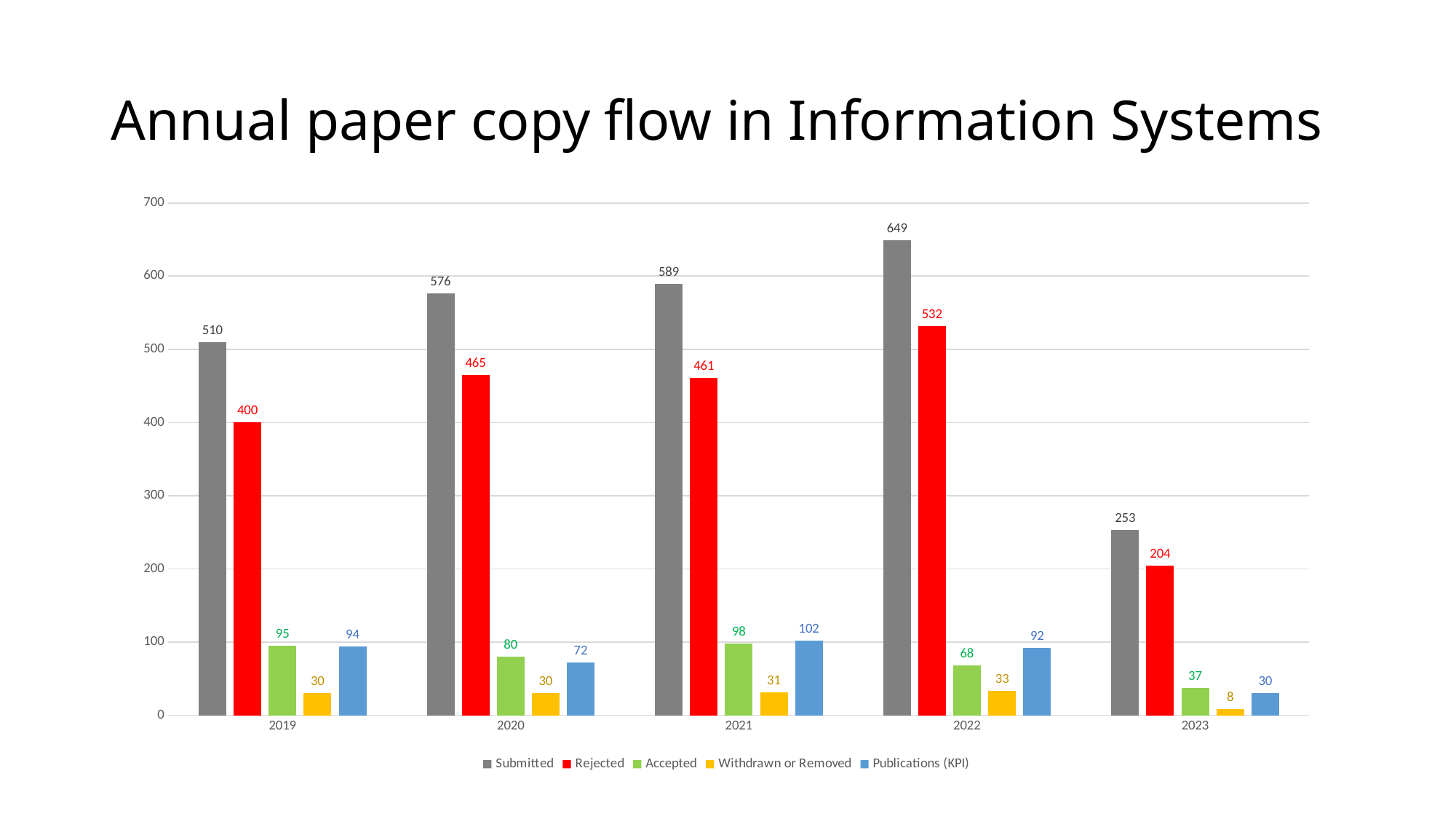
Which is larger in 2020: Accepted or Publications (KPI)? Accepted What is the number of Submitted papers in 2022? 649 What is the number of Rejected papers in 2020? 465 What is the title of the chart? Annual paper copy flow in Information Systems What is the value for Withdrawn or Removed in 2023? 8 What kind of chart is shown on the slide? Bar chart How many years are shown on the x axis? 5 What is the value for Publications (KPI) in 2021? 102 In which year was the number of Submitted papers highest? 2022 What is the difference between Submitted and Rejected papers in 2019? 110 How many series does the legend list? 5 In which year was the number of Accepted papers lowest? 2023